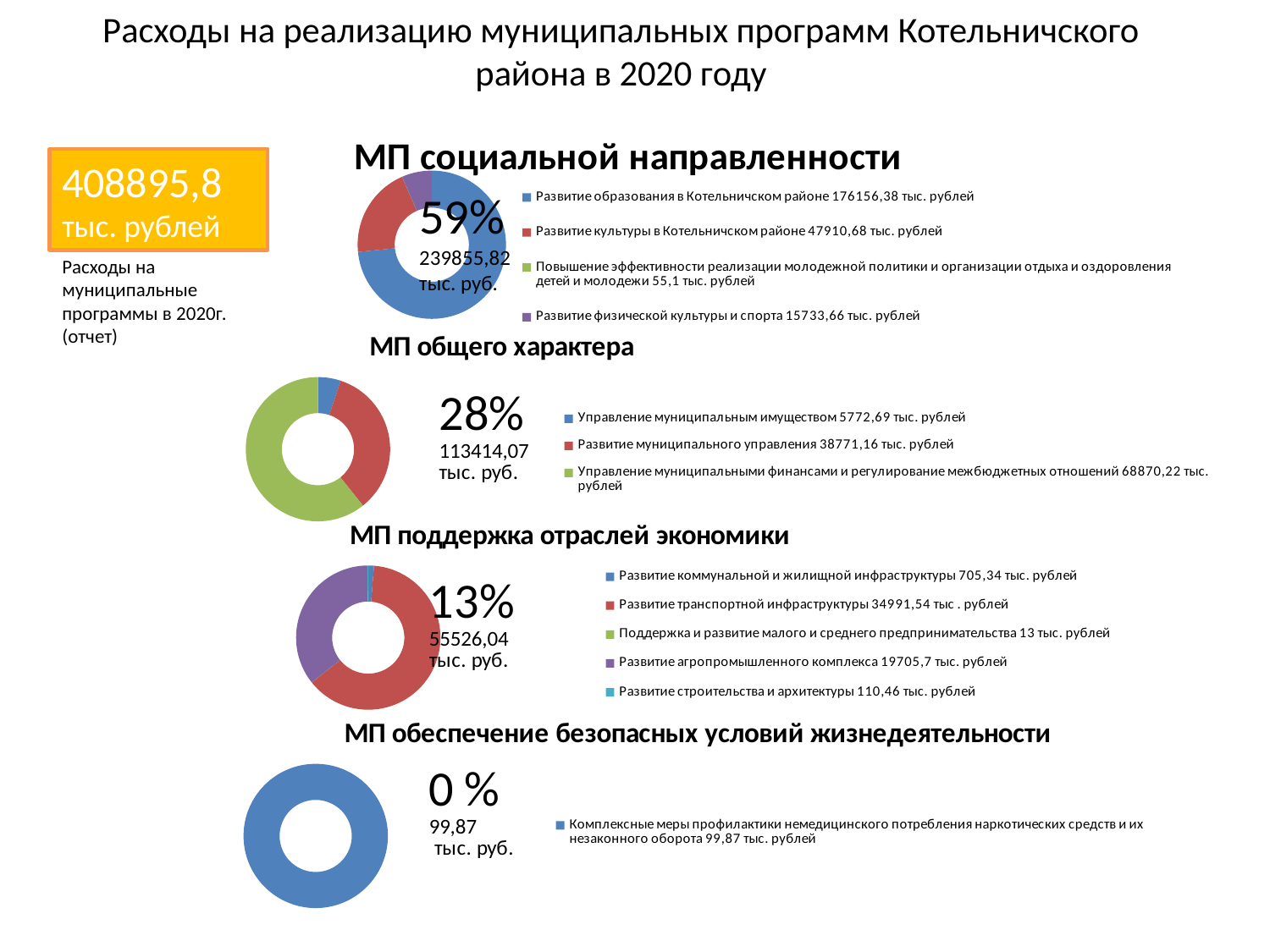
On the 'МП поддержка отраслей экономики' chart, which is larger: 'Развитие транспортной инфраструктуры' or 'Развитие агропромышленного комплекса'? Развитие транспортной инфраструктуры How many categories does the legend of the 'МП поддержка отраслей экономики' chart list? 5 On the 'МП общего характера' chart, what is the value for 'Развитие муниципального управления'? 38771,16 тыс. рублей What share of total expenditure does the 'МП социальной направленности' chart show? 59% On the 'МП социальной направленности' chart, which category has the smallest value? Повышение эффективности реализации молодежной политики и организации отдыха и оздоровления детей и молодежи On the 'МП общего характера' chart, which category has the largest value? Управление муниципальными финансами и регулирование межбюджетных отношений What total amount is printed next to the 'МП общего характера' chart? 113414,07 тыс. руб. What kind of chart is used for 'МП обеспечение безопасных условий жизнедеятельности'? Donut (pie) chart On the 'МП социальной направленности' chart, how much is spent on 'Развитие образования в Котельничском районе'? 176156,38 тыс. рублей What percentage is printed next to the 'МП обеспечение безопасных условий жизнедеятельности' chart? 0 % How many categories does the legend of the 'МП социальной направленности' chart list? 4 On the 'МП поддержка отраслей экономики' chart, what is the value for 'Поддержка и развитие малого и среднего предпринимательства'? 13 тыс. рублей